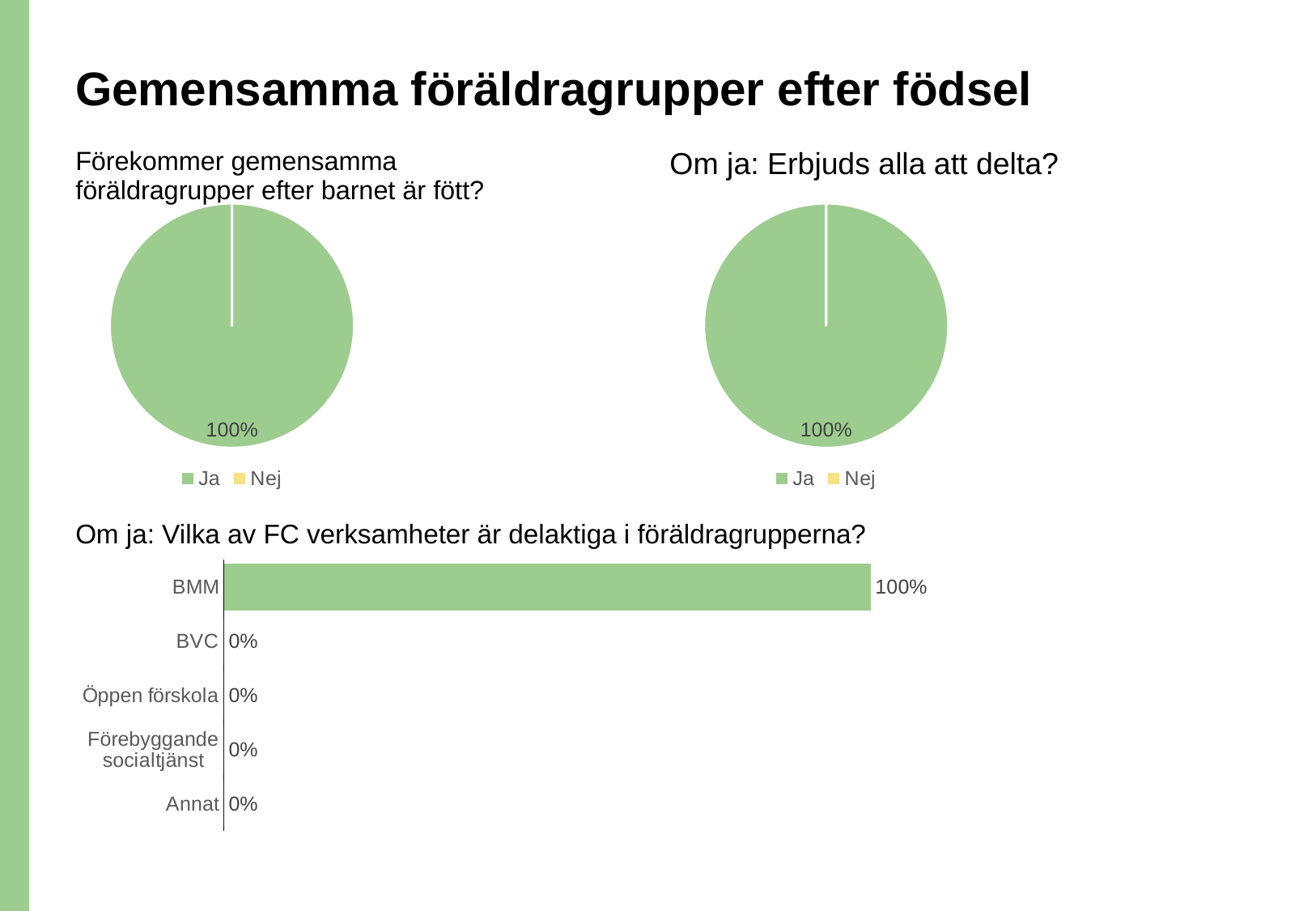
In the bar chart titled 'Om ja: Vilka av FC verksamheter är delaktiga i föräldragrupperna?', what is the value for BVC? 0% In the bar chart titled 'Om ja: Vilka av FC verksamheter är delaktiga i föräldragrupperna?', what is the difference between the values for BMM and Annat? 100% In the bar chart titled 'Om ja: Vilka av FC verksamheter är delaktiga i föräldragrupperna?', what is the value for Öppen förskola? 0% In the pie chart titled 'Om ja: Erbjuds alla att delta?', what share does 'Ja' have? 100% In the pie chart titled 'Förekommer gemensamma föräldragrupper efter barnet är fött?', what share does 'Ja' have? 100% In the bar chart titled 'Om ja: Vilka av FC verksamheter är delaktiga i föräldragrupperna?', how many categories are shown? 5 What kind of chart is the chart titled 'Förekommer gemensamma föräldragrupper efter barnet är fött?'? pie chart In the bar chart titled 'Om ja: Vilka av FC verksamheter är delaktiga i föräldragrupperna?', which category has the highest value? BMM In the bar chart titled 'Om ja: Vilka av FC verksamheter är delaktiga i föräldragrupperna?', which is larger, the value for BMM or the value for Förebyggande socialtjänst? BMM In the bar chart titled 'Om ja: Vilka av FC verksamheter är delaktiga i föräldragrupperna?', what is the value for BMM? 100% How many entries does the legend list in the pie chart titled 'Om ja: Erbjuds alla att delta?'? 2 What kind of chart is the chart titled 'Om ja: Vilka av FC verksamheter är delaktiga i föräldragrupperna?'? bar chart